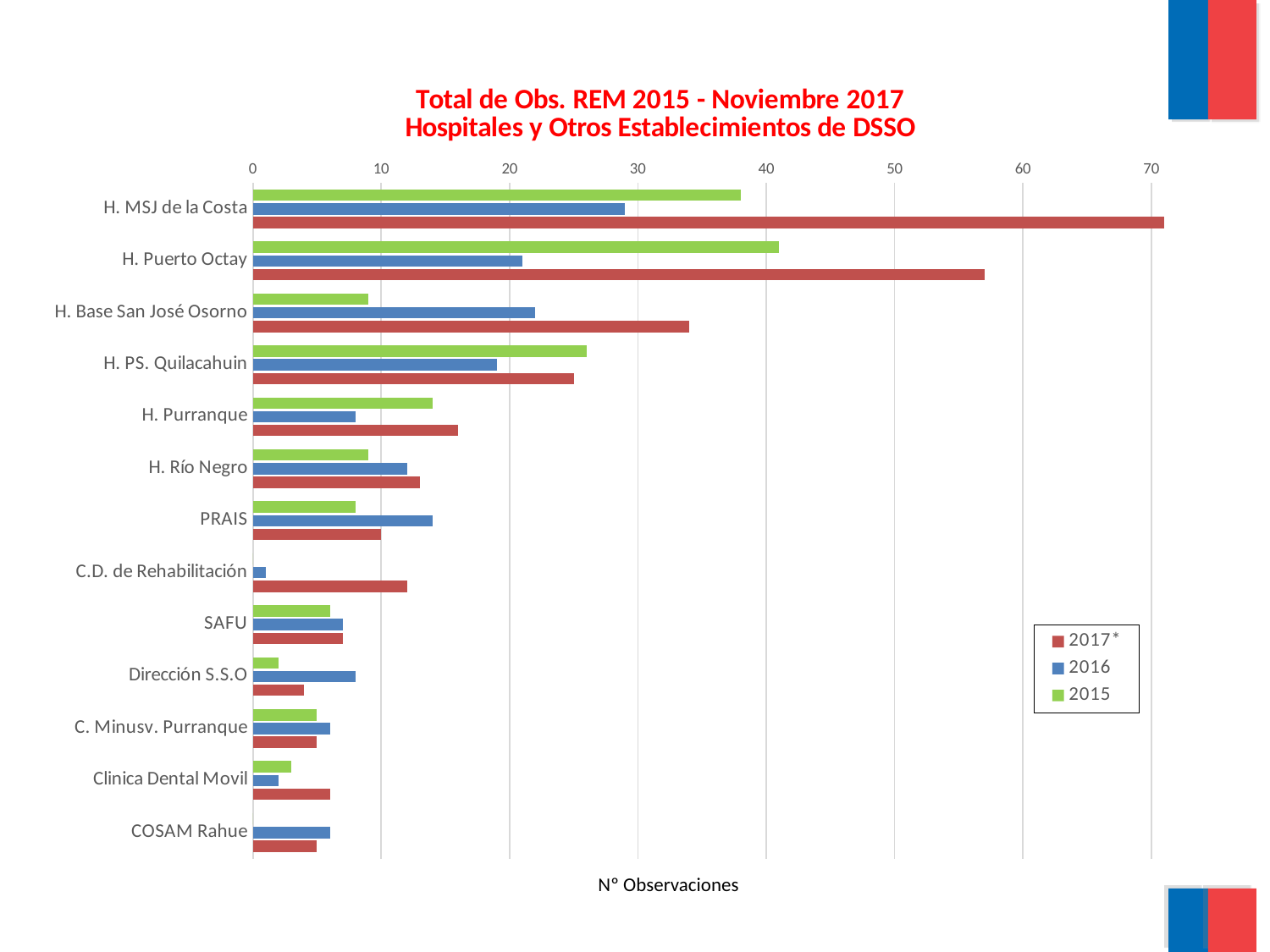
Which establishment has the highest value for the 2017* series? H. MSJ de la Costa What kind of chart is shown on the slide? bar chart Is the 2017* value for H. MSJ de la Costa greater or less than 60? greater How many establishments (categories) are shown on the y axis? 13 Is the 2015 value for H. Base San José Osorno greater or less than 10? less For PRAIS, which series has the larger value, 2016 or 2017*? 2016 What is the label of the x axis? N° Observaciones Which establishment has the highest value for the 2016 series? H. MSJ de la Costa How many series does the legend list? 3 Is the 2017* value for H. Base San José Osorno greater or less than 30? greater For H. Puerto Octay, which series has the larger value, 2015 or 2016? 2015